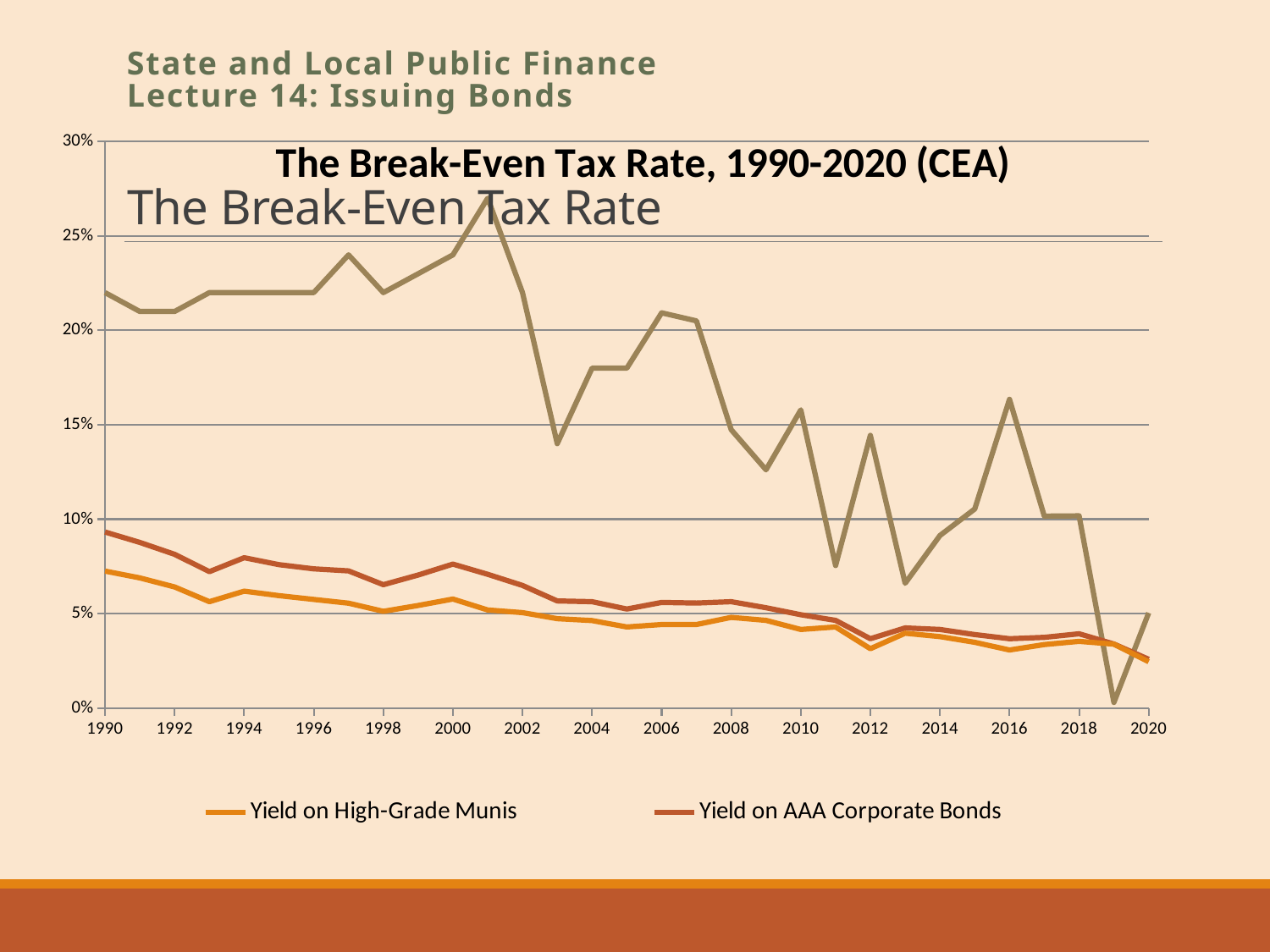
Which two series are named in the legend? Yield on High-Grade Munis; Yield on AAA Corporate Bonds Does the Yield on High-Grade Munis generally rise or fall from 1990 to 2020? fall What kind of chart is shown on the slide? line chart What is the title printed inside the chart area? The Break-Even Tax Rate, 1990-2020 (CEA) In 1990, which is larger: the Yield on High-Grade Munis or the Yield on AAA Corporate Bonds? Yield on AAA Corporate Bonds Is the value of the unlabeled tan line in 2001 greater or less than 25%? greater Is the Yield on High-Grade Munis in 2020 greater or less than 5%? less Is the Yield on AAA Corporate Bonds in 1990 greater or less than 10%? less How many series does the chart's legend list? 2